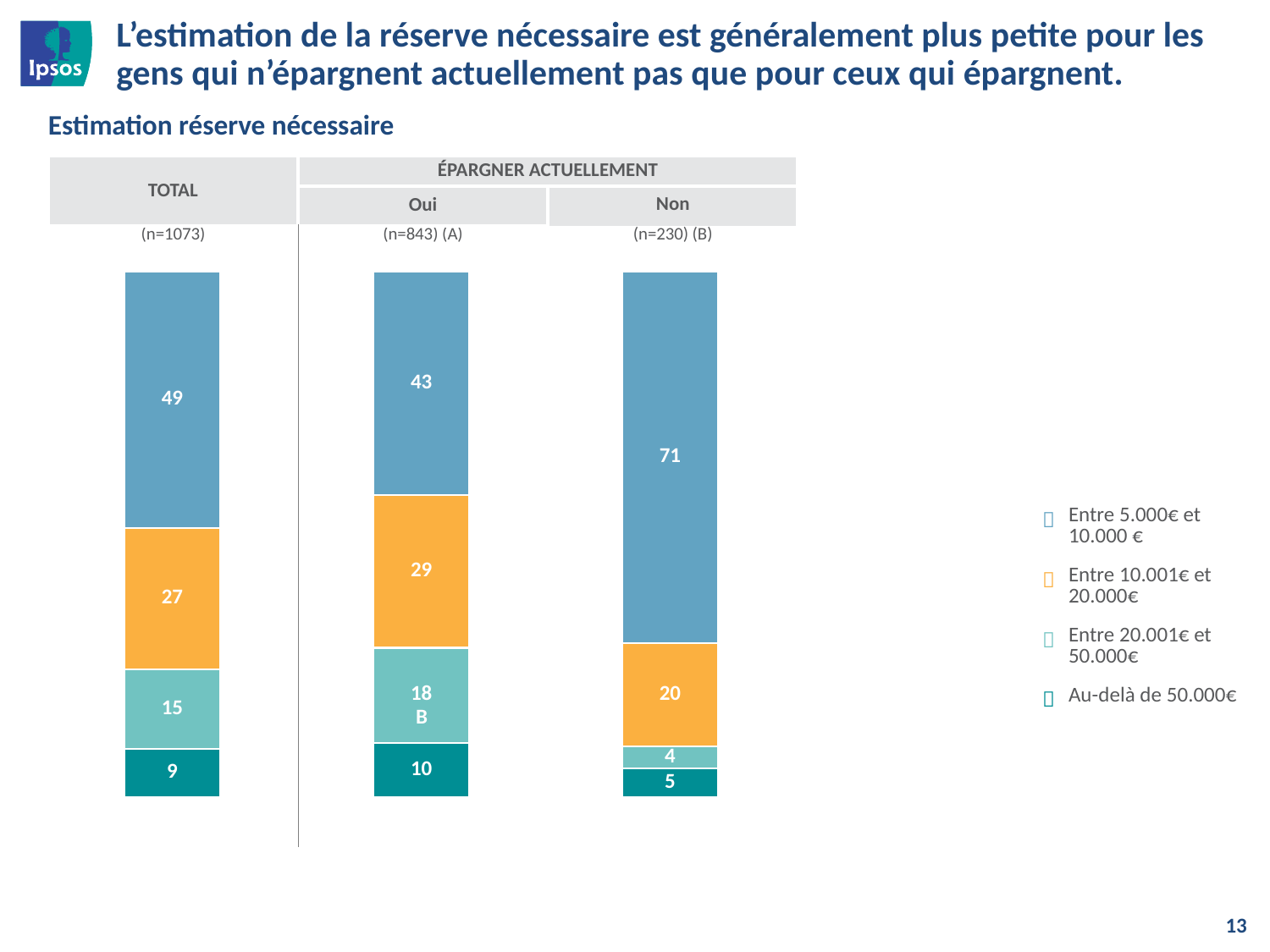
How many bars are plotted in the chart? 3 How many entries does the legend list? 4 Which is larger: the orange segment of the TOTAL bar or the orange segment of the Oui bar? Oui What is the total of all segments in the TOTAL bar? 100 What is the value of the top (blue) segment of the Non bar? 71 What kind of chart is shown on the slide? Stacked bar chart What is the smallest value shown in the Non bar? 4 Which bar has the largest top (blue) segment? Non What is the sample size shown for the Non group? n=230 What is the value of the orange segment of the Oui bar? 29 What is the difference between the top (blue) segment of the Non bar and that of the Oui bar? 28 What is the value of the bottom (dark teal) segment of the TOTAL bar? 9